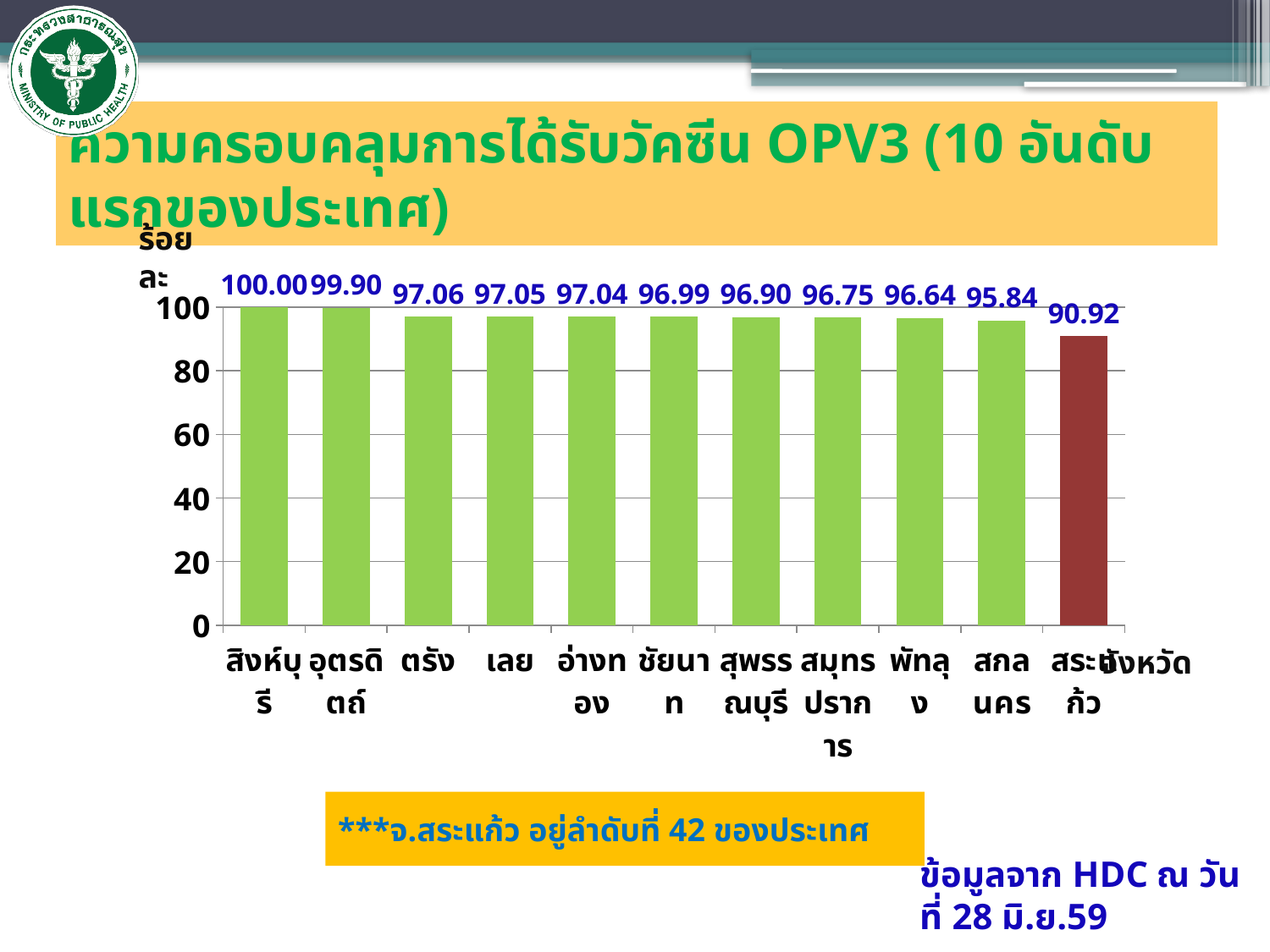
What is the difference between the values for อุตรดิตถ์ and สกลนคร? 4.06 Which province has the lowest value? สระแก้ว What is the value for สระแก้ว? 90.92 Which bar is shown in a different colour (dark red) from the others? สระแก้ว Which is larger, the value for ตรัง or the value for สระแก้ว? ตรัง What is the difference between the values for สิงห์บุรี and สระแก้ว? 9.08 What is the value for สิงห์บุรี? 100.00 Which province has the highest value? สิงห์บุรี What kind of chart is shown on the slide? bar chart What is the value for สกลนคร? 95.84 How many provinces are shown in the chart? 11 What is the value for อุตรดิตถ์? 99.90